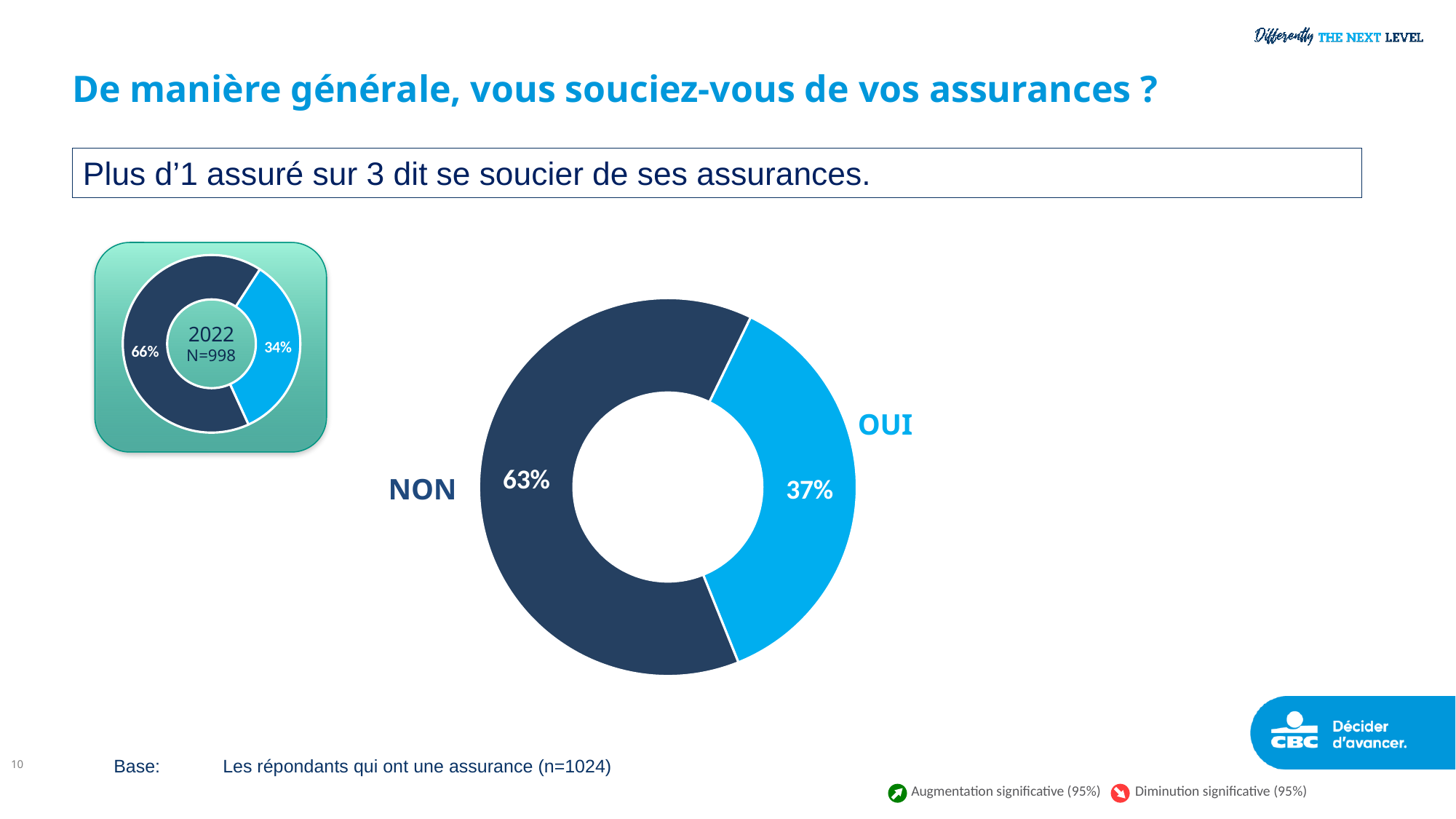
In the large donut chart, how many categories are shown? 2 In the large donut chart, which is larger, OUI or NON? NON In the small donut chart on the left, what value is shown for the light blue slice? 34% In the large donut chart, what is the difference between the NON and OUI values? 26% What kind of chart is the large chart in the centre of the slide? Donut (pie) chart In the large donut chart, what is the value for NON? 63% In the small donut chart on the left, what year and sample size are shown in the centre? 2022, N=998 In the large donut chart, what colour is the OUI slice? Light blue In the large donut chart, which category has the largest share? NON In the large donut chart, what is the value for OUI? 37% In the small donut chart on the left, what value is shown for the dark blue slice? 66% In the large donut chart, which category has the smallest share? OUI